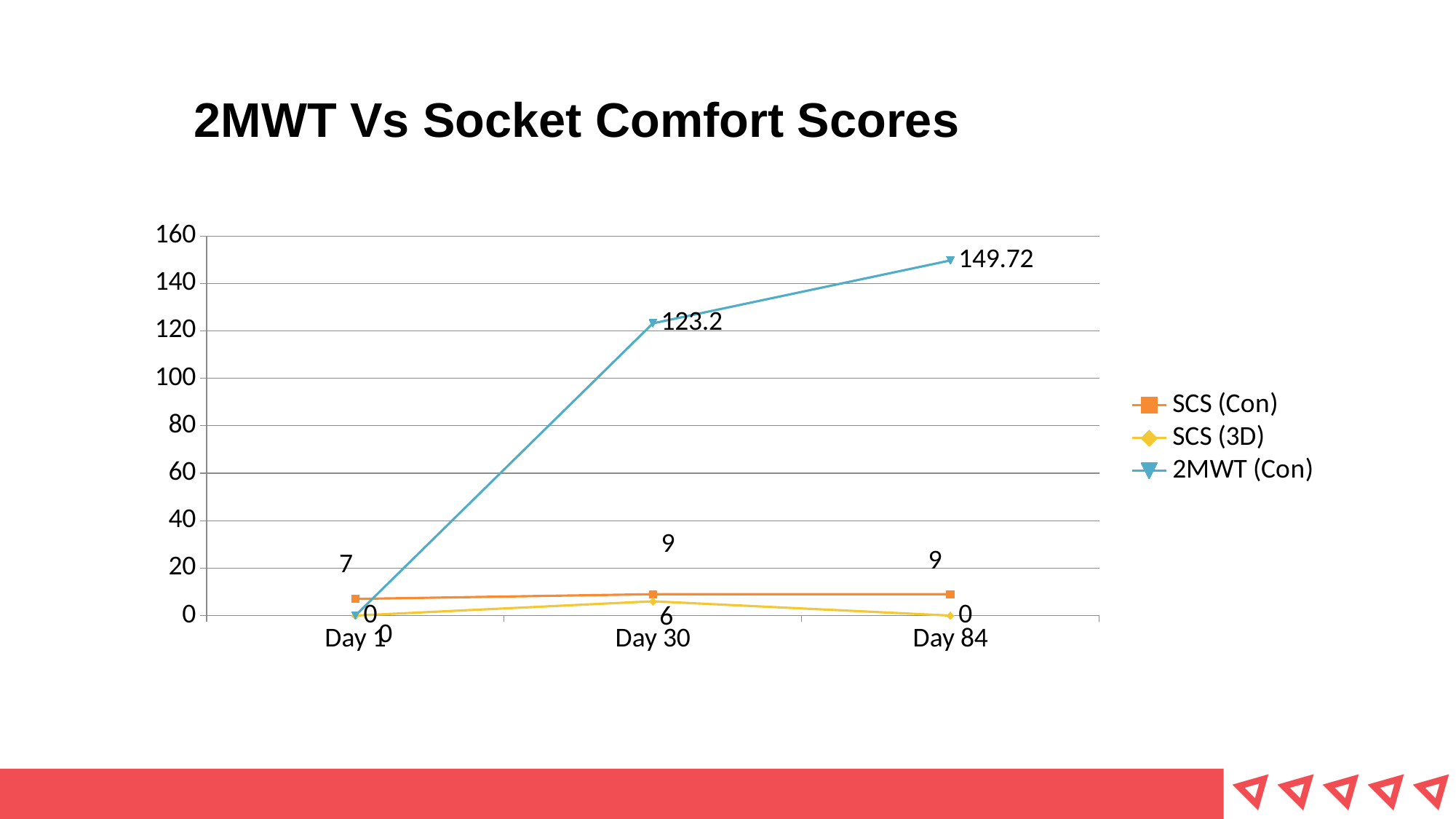
What is the value of SCS (3D) at Day 30? 6 What type of chart is shown on the slide? line chart What is the difference between the 2MWT (Con) values at Day 84 and Day 30? 26.52 At which day is 2MWT (Con) highest? Day 84 Does the 2MWT (Con) series rise or fall from Day 1 to Day 84? rise What is the value of 2MWT (Con) at Day 30? 123.2 How many series does the legend list? 3 What is the value of SCS (Con) at Day 1? 7 How many categories are shown on the x axis? 3 What is the value of 2MWT (Con) at Day 84? 149.72 Which is larger at Day 30: SCS (Con) or SCS (3D)? SCS (Con) What is the title of the chart? 2MWT Vs Socket Comfort Scores